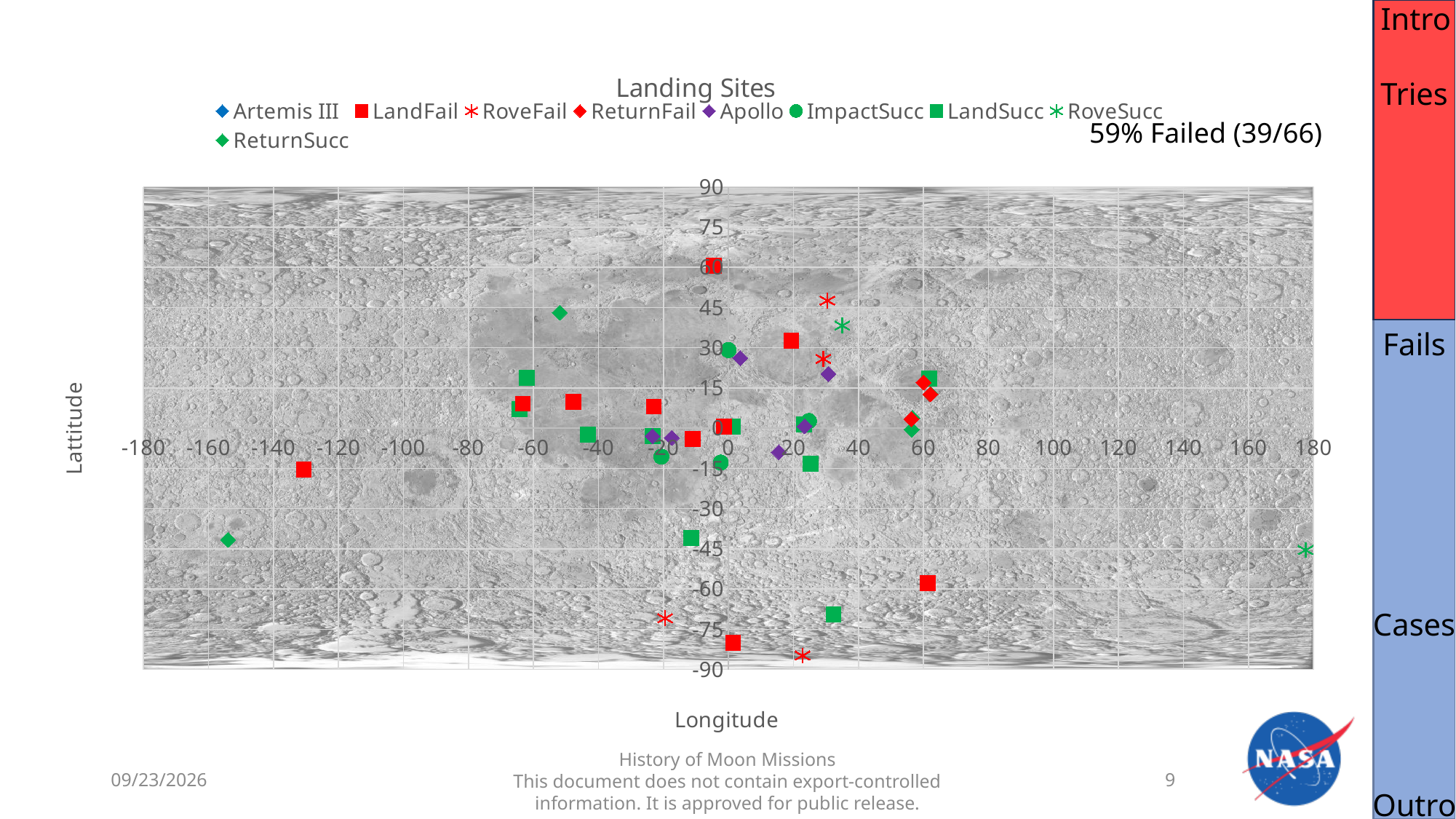
How many series does the chart legend list? 9 Is the longitude of the leftmost LandFail point greater or less than -100? less What is the maximum value shown on the longitude axis of the chart? 180 What kind of chart is shown on the slide? scatter chart What is the label of the horizontal axis of the chart? Longitude What is the minimum value shown on the latitude axis of the chart? -90 Is the latitude of the RoveSucc point at the far right edge of the map greater or less than -30? less What is the title of the chart? Landing Sites Is the latitude of the LandFail point located near longitude -130 greater or less than 0? less According to the annotation on the chart, what percentage of missions failed? 59% According to the annotation on the chart, how many missions failed out of the total? 39/66